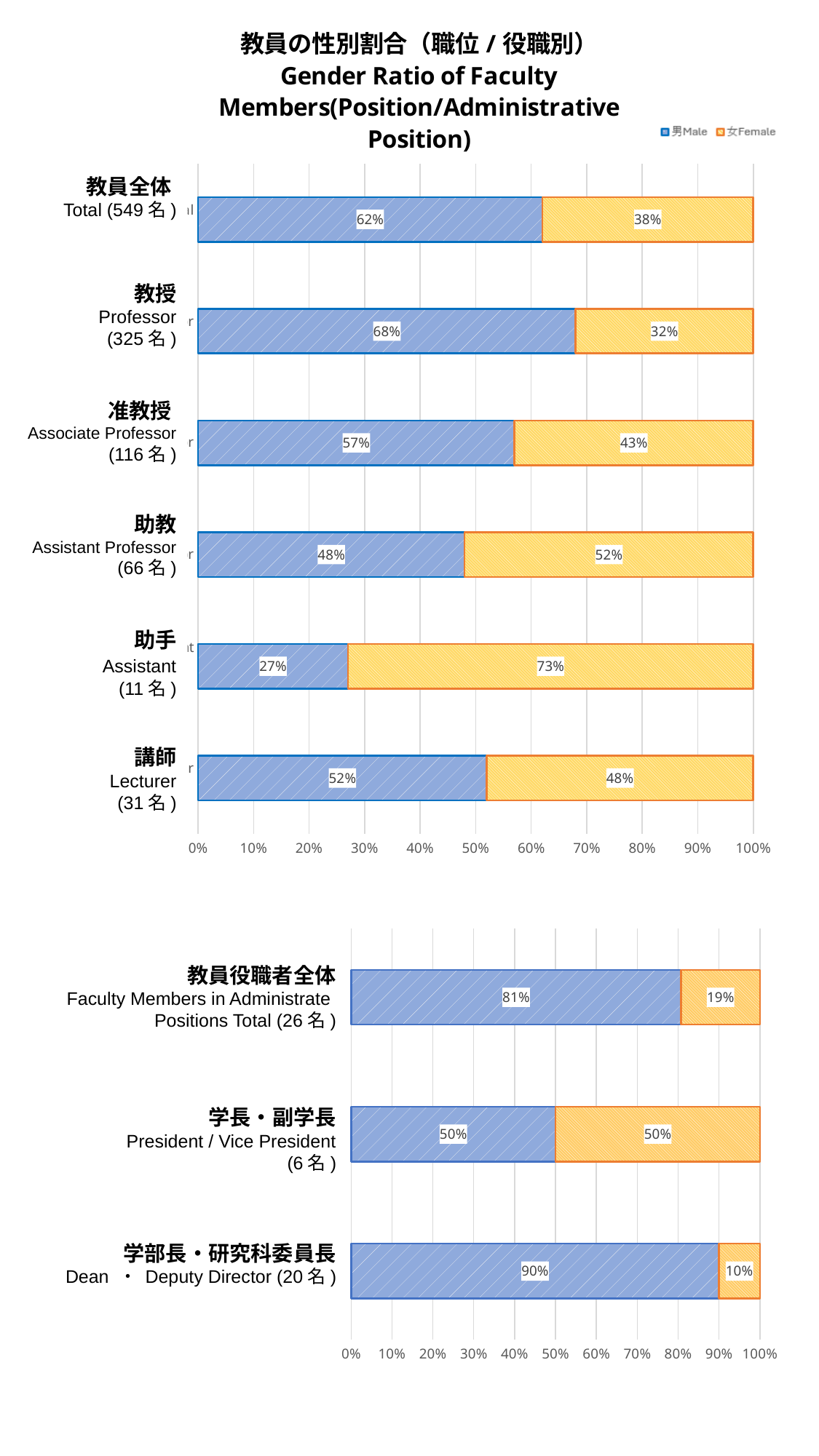
In the top chart, which position has the lowest Male percentage? Assistant How many series does the legend list? 2 In the top chart, what is the difference between the Male and Female percentages for Associate Professor? 14% In the top chart (Gender Ratio of Faculty Members by position), what is the Male percentage for Professor? 68% In the bottom chart, what is the difference between the Male percentages for Dean / Deputy Director and President / Vice President? 40% In the bottom chart, what is the Female percentage for Faculty Members in Administrative Positions Total? 19% In the top chart, is the Male percentage larger for Professor or for Lecturer? Professor In the top chart, what is the Female percentage for Assistant? 73% In the top chart, which position has the highest Female percentage? Assistant In the top chart, how many positions (categories) are shown? 6 What kind of chart is used on this slide? Stacked bar chart In the bottom chart (administrative positions), what is the Male percentage for Dean / Deputy Director? 90%